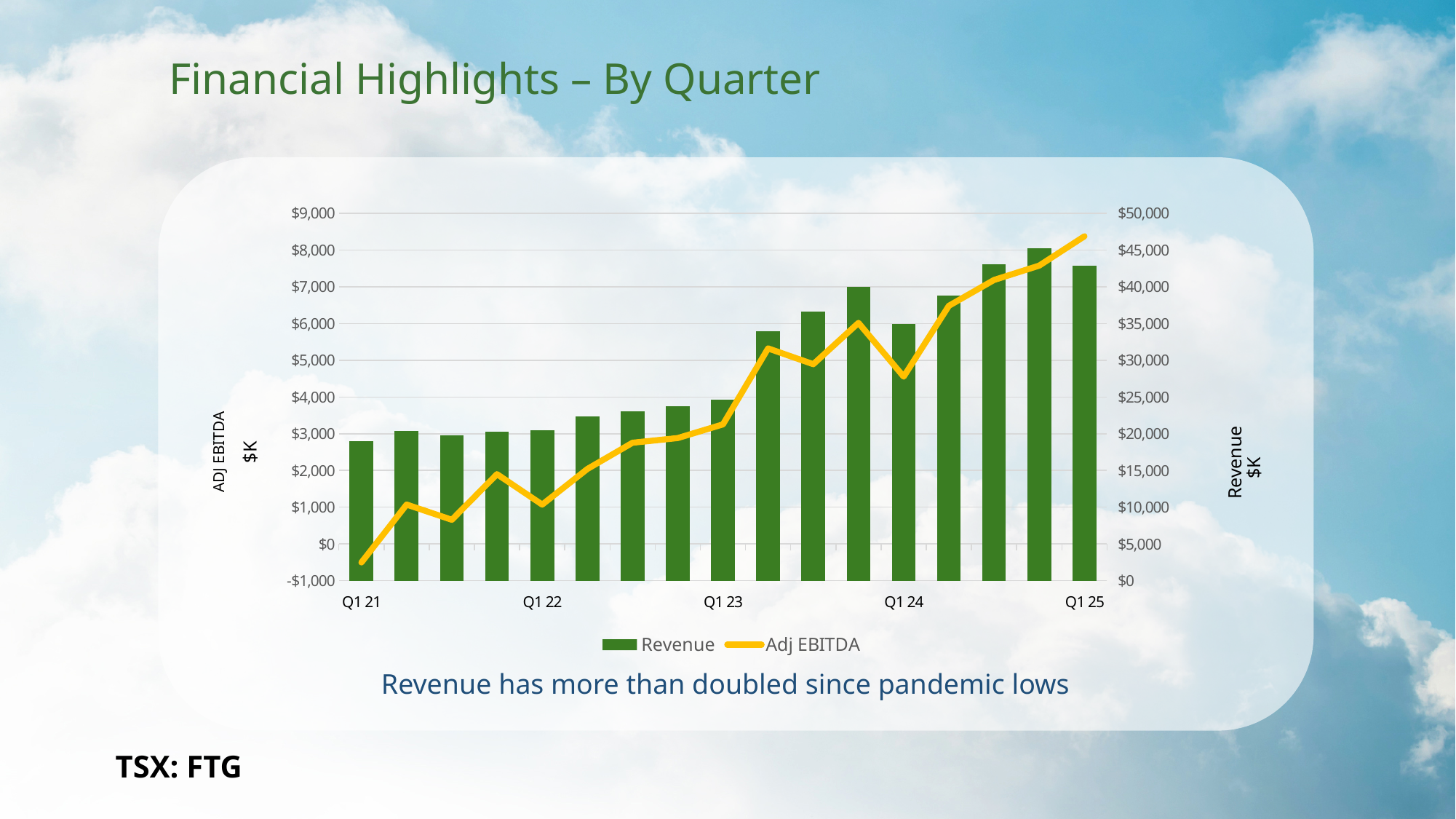
Is the Adj EBITDA value for Q1 21 greater or less than $0? less Which labelled quarter has the lowest Adj EBITDA value? Q1 21 Which labelled quarter has the highest Adj EBITDA value? Q1 25 What kind of chart is shown on the slide? A combination bar and line chart Is the Adj EBITDA value for Q1 25 greater or less than $8,000? greater Which is larger, the Revenue for Q1 25 or the Revenue for Q1 21? Q1 25 Is the Revenue value for Q1 25 greater or less than $40,000? greater Which labelled quarter has the lowest Revenue bar? Q1 21 How many quarterly bars are plotted in the chart? 17 How many series does the legend list? 2 Does Revenue generally rise or fall from Q1 21 to Q1 25? Rise